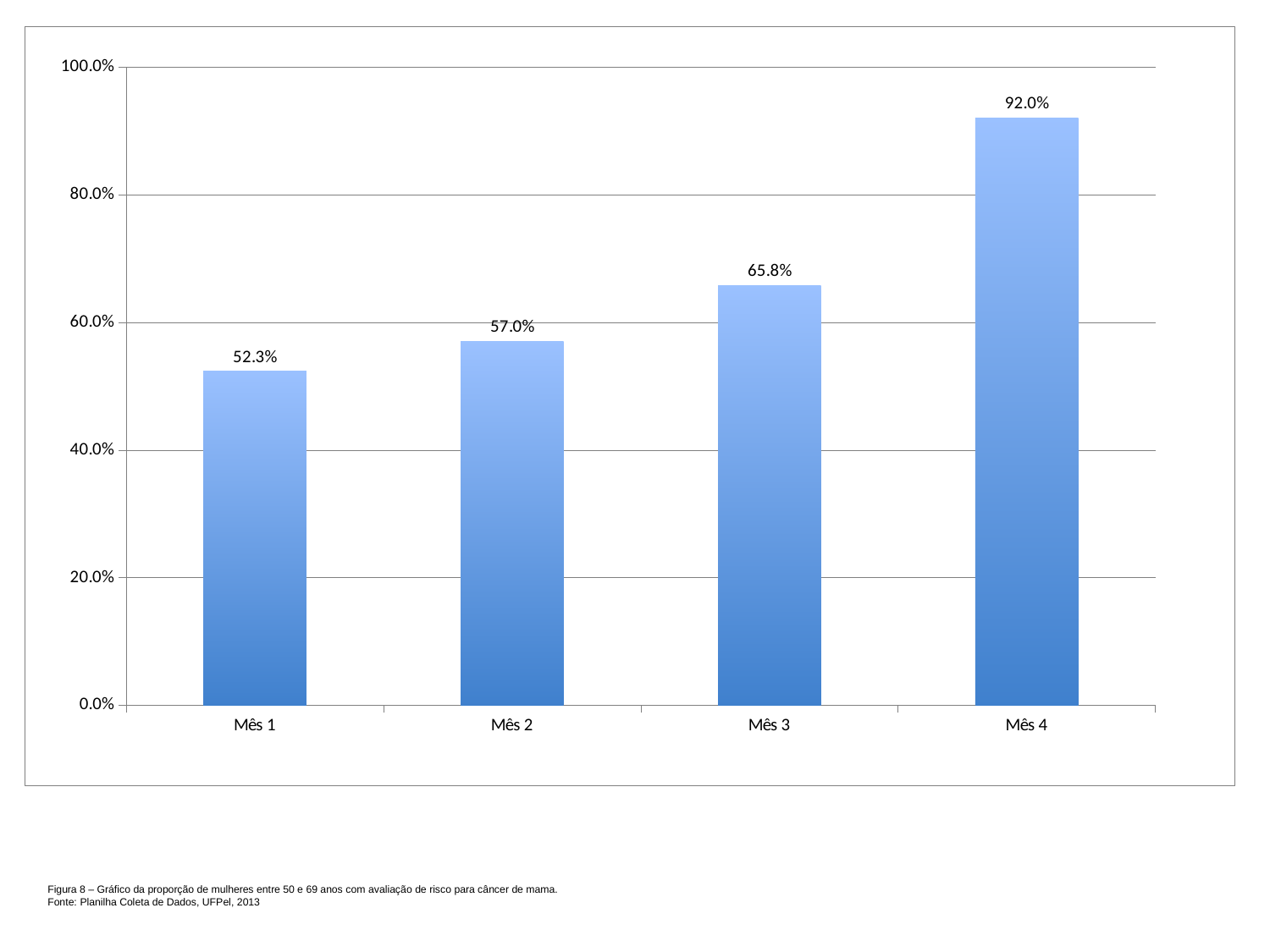
Which month has the highest value? Mês 4 What is the value for Mês 1? 52.3% How many months are shown on the chart? 4 Do the values rise or fall from Mês 1 to Mês 4? Rise Is the value for Mês 4 greater or less than 80.0%? greater What is the value for Mês 4? 92.0% What is the difference between the values for Mês 2 and Mês 1? 4.7% Which month has the lowest value? Mês 1 Which is larger, the value for Mês 2 or the value for Mês 3? Mês 3 What kind of chart is shown on the slide? Bar chart What is the value for Mês 3? 65.8% What is the difference between the values for Mês 4 and Mês 3? 26.2%